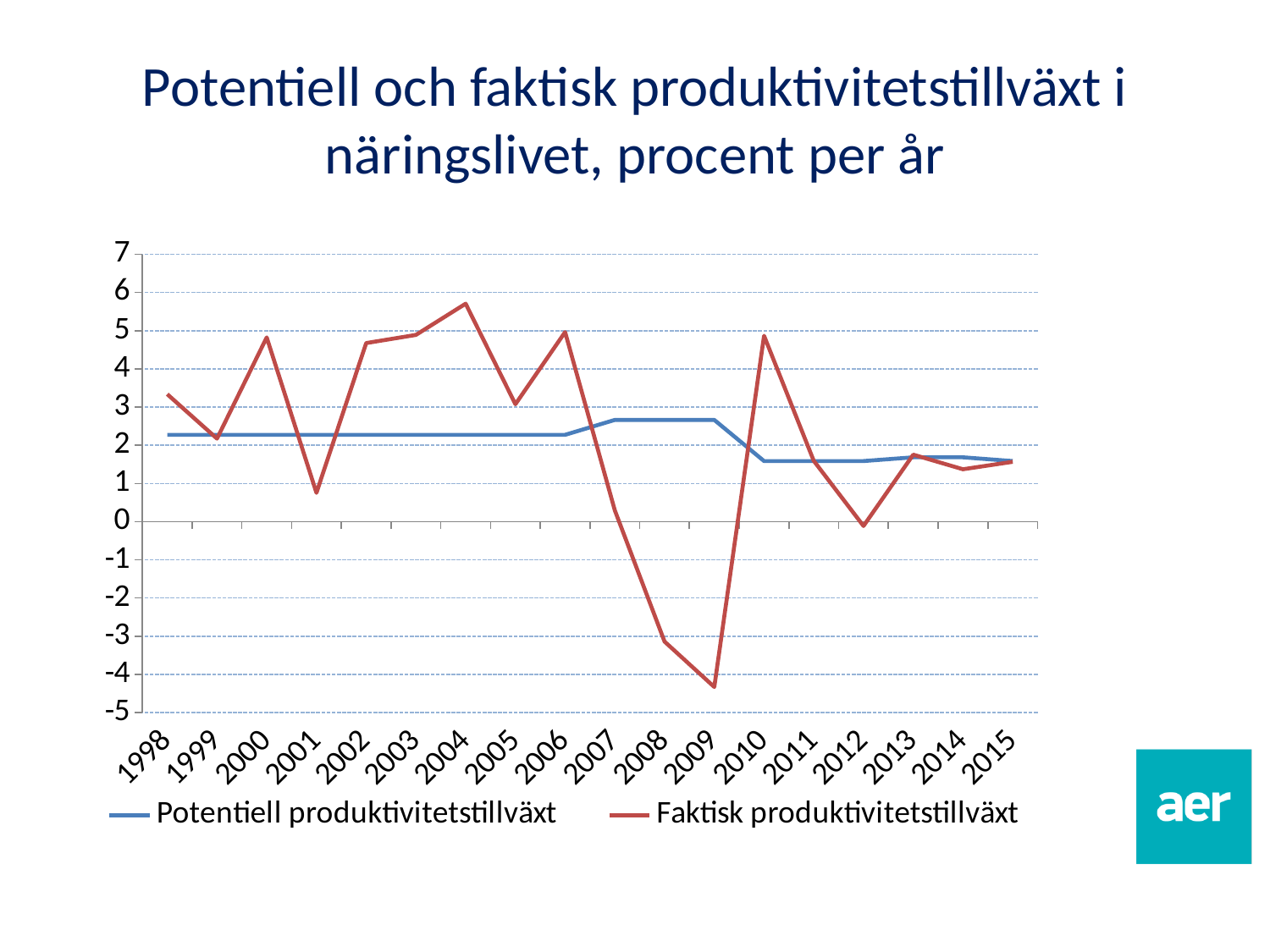
How many series does the legend list? 2 What colour is the line for Faktisk produktivitetstillväxt? red Is the value for Potentiell produktivitetstillväxt in 1998 greater or less than 2? greater Does Faktisk produktivitetstillväxt rise or fall from 2009 to 2010? rise Is the value for Faktisk produktivitetstillväxt in 2001 greater or less than 1? less Is the value for Faktisk produktivitetstillväxt in 2004 greater or less than 5? greater How many years are shown on the x axis? 18 In which year is Faktisk produktivitetstillväxt lowest? 2009 In which year is Faktisk produktivitetstillväxt highest? 2004 What kind of chart is shown on the slide? line chart In 2009, which series has the larger value, Potentiell produktivitetstillväxt or Faktisk produktivitetstillväxt? Potentiell produktivitetstillväxt